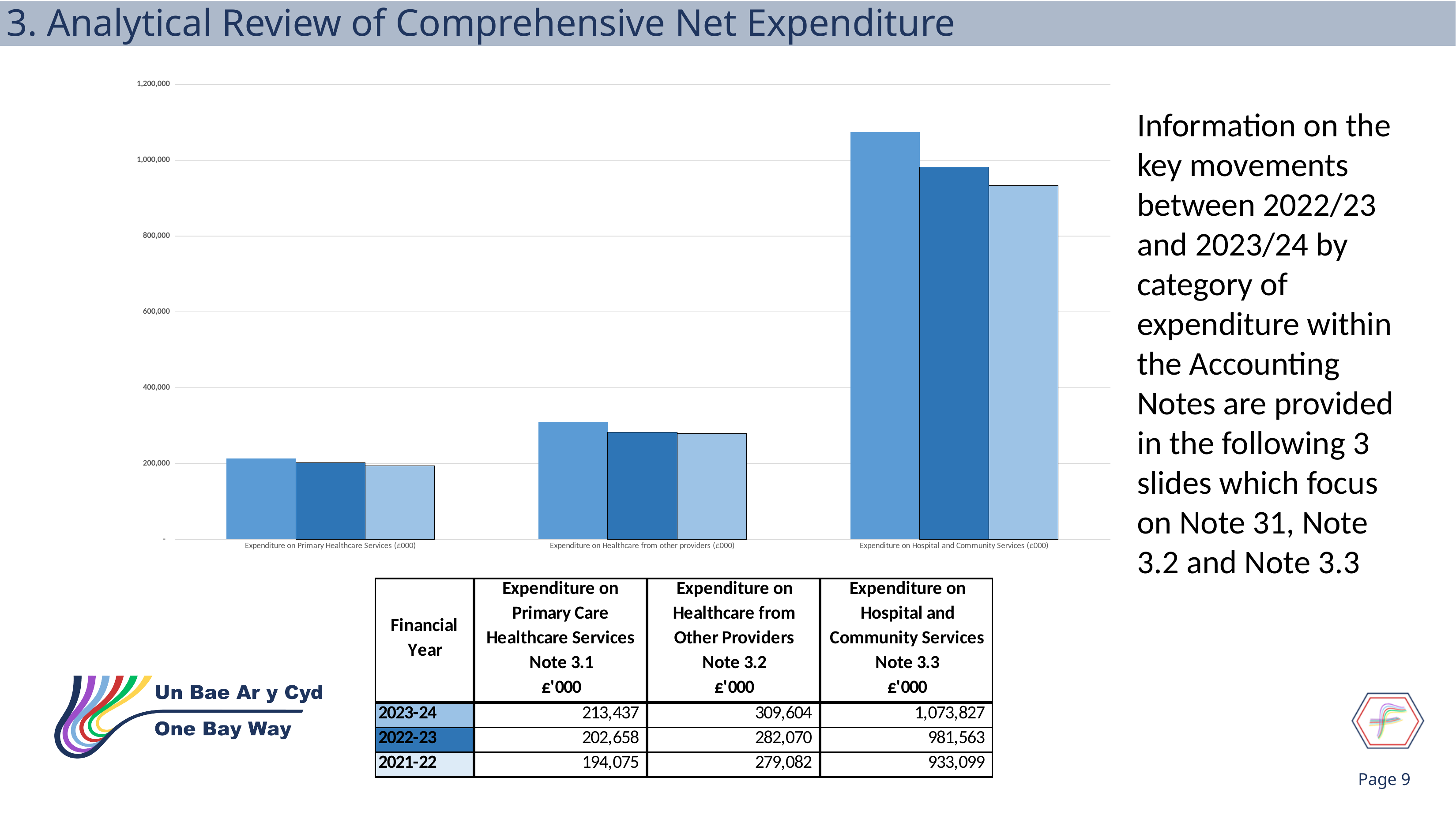
Which is larger: expenditure on Healthcare from Other Providers in 2023-24 or in 2021-22? 2023-24 What was the expenditure on Primary Care Healthcare Services in 2021-22 (£'000)? 194,075 Which expenditure category has the lowest value in 2023-24? Expenditure on Primary Healthcare Services What was the expenditure on Healthcare from Other Providers in 2022-23 (£'000)? 282,070 How many financial years are plotted as series in the chart? 3 How many expenditure categories are shown on the x axis of the chart? 3 What was the expenditure on Hospital and Community Services in 2023-24 (£'000)? 1,073,827 Is the 2022-23 value for Expenditure on Hospital and Community Services greater or less than 1,000,000? less What is the difference between the 2023-24 and 2022-23 expenditure on Hospital and Community Services (£'000)? 92,264 Which expenditure category has the highest value in every year shown? Expenditure on Hospital and Community Services What kind of chart is shown on the slide? bar chart Across the three years, does expenditure on Primary Care Healthcare Services rise or fall from 2021-22 to 2023-24? rise